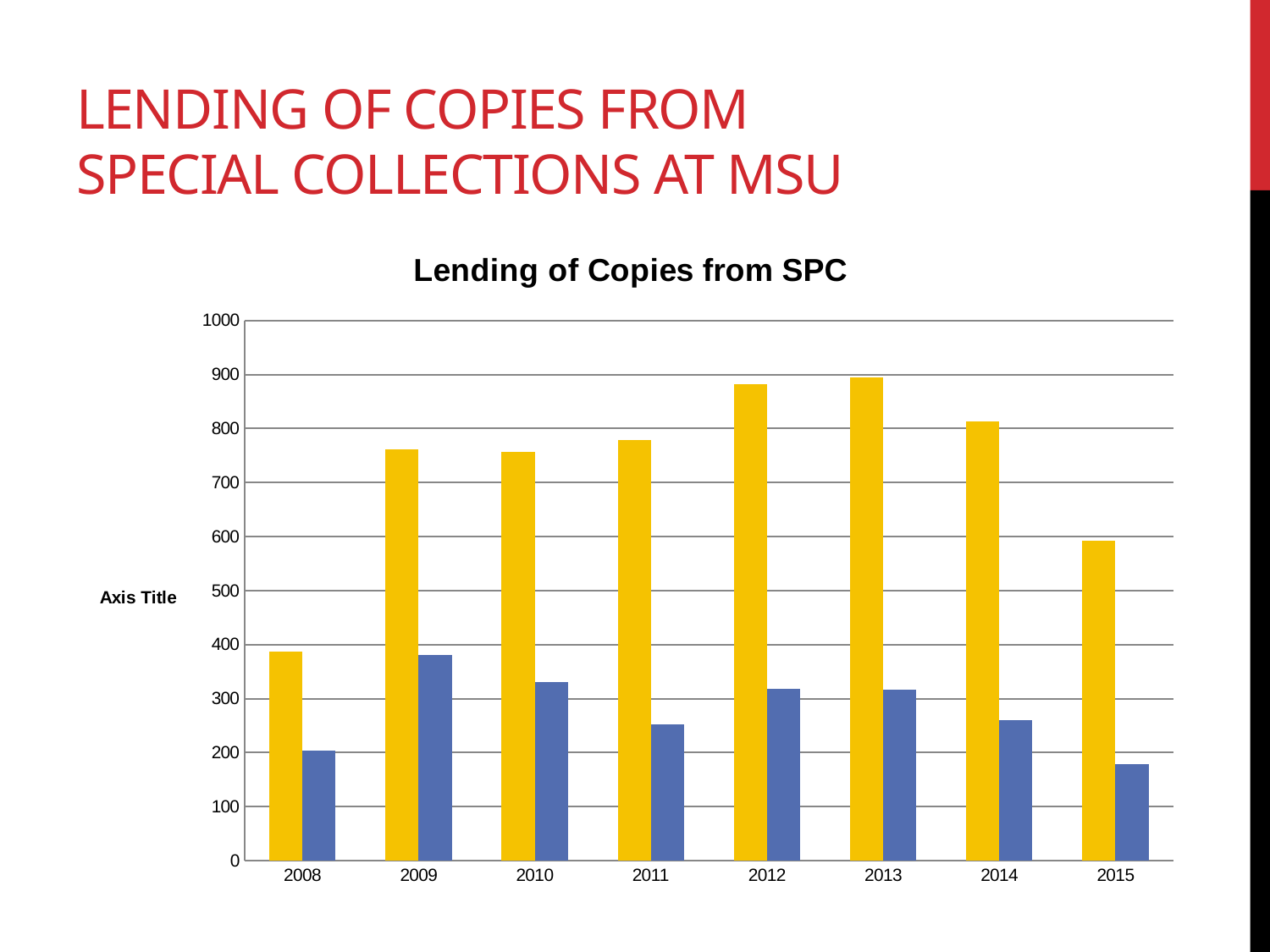
What is the title of the chart? Lending of Copies from SPC Is the yellow bar for 2015 greater or less than 700? less How many years are shown on the x axis of the chart? 8 Which year has the lowest blue bar? 2015 Is the blue bar for 2008 greater or less than 300? less Is the yellow bar for 2012 greater or less than 800? greater Which is larger, the yellow bar for 2012 or the yellow bar for 2015? 2012 What kind of chart is shown on the slide? bar chart Do the yellow bars rise or fall from 2013 to 2015? fall Which year has the highest blue bar? 2009 Which year has the lowest yellow bar? 2008